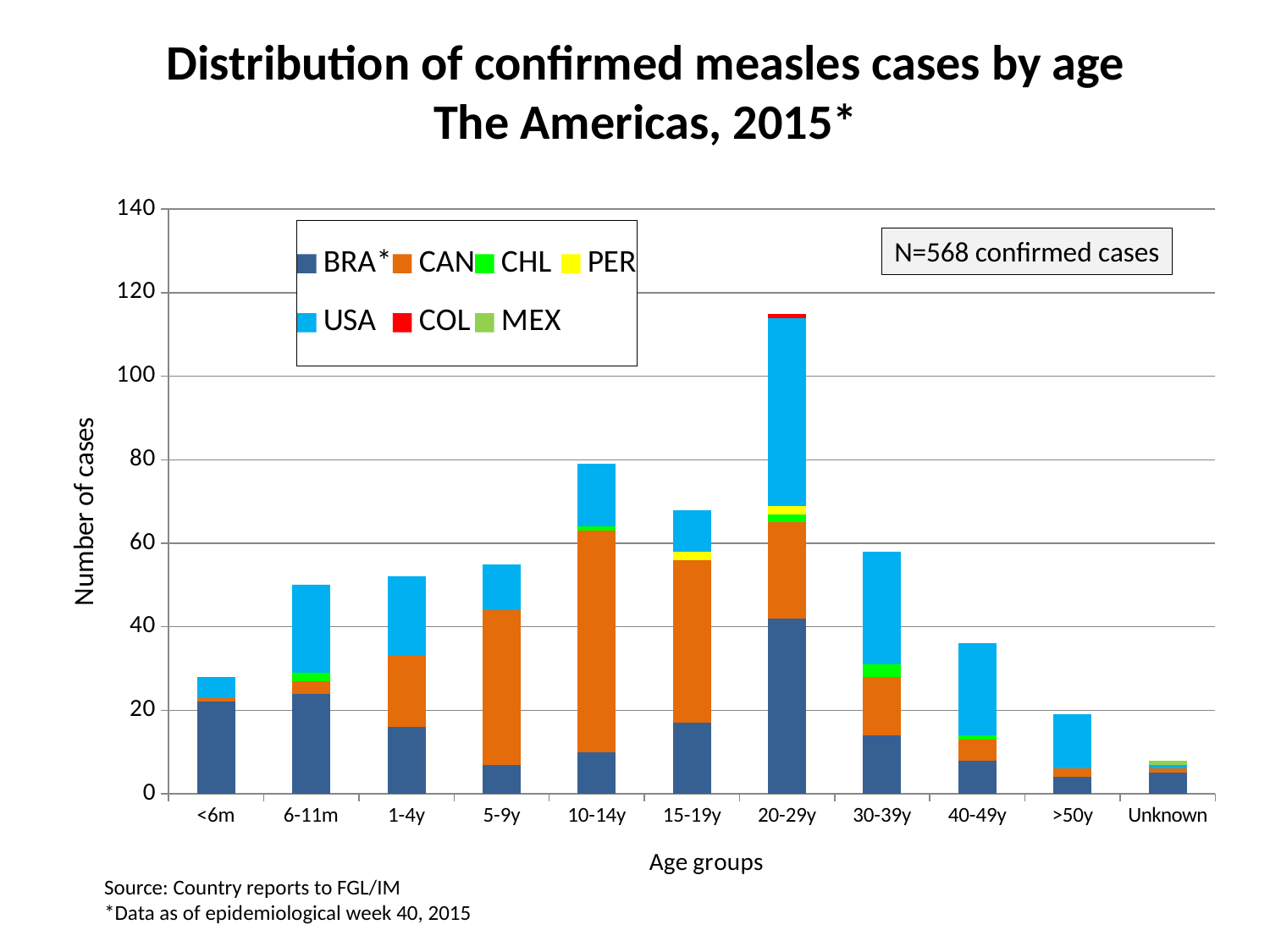
How many age group categories are shown on the x axis? 11 How many series does the legend list? 7 How many confirmed cases in total does the text box on the chart report? N=568 confirmed cases What kind of chart is shown on the slide? Stacked bar chart Which age group has the highest total number of confirmed measles cases? 20-29y Which age group has the lowest total number of confirmed measles cases? Unknown Is the total number of cases for the <6m age group greater or less than 20? greater Is the total number of cases for the 10-14y age group greater or less than 60? greater Is the total number of cases for the 20-29y age group greater or less than 100? greater Which age group has a higher total number of cases, 30-39y or 40-49y? 30-39y Which age group has a higher total number of cases, 10-14y or 15-19y? 10-14y